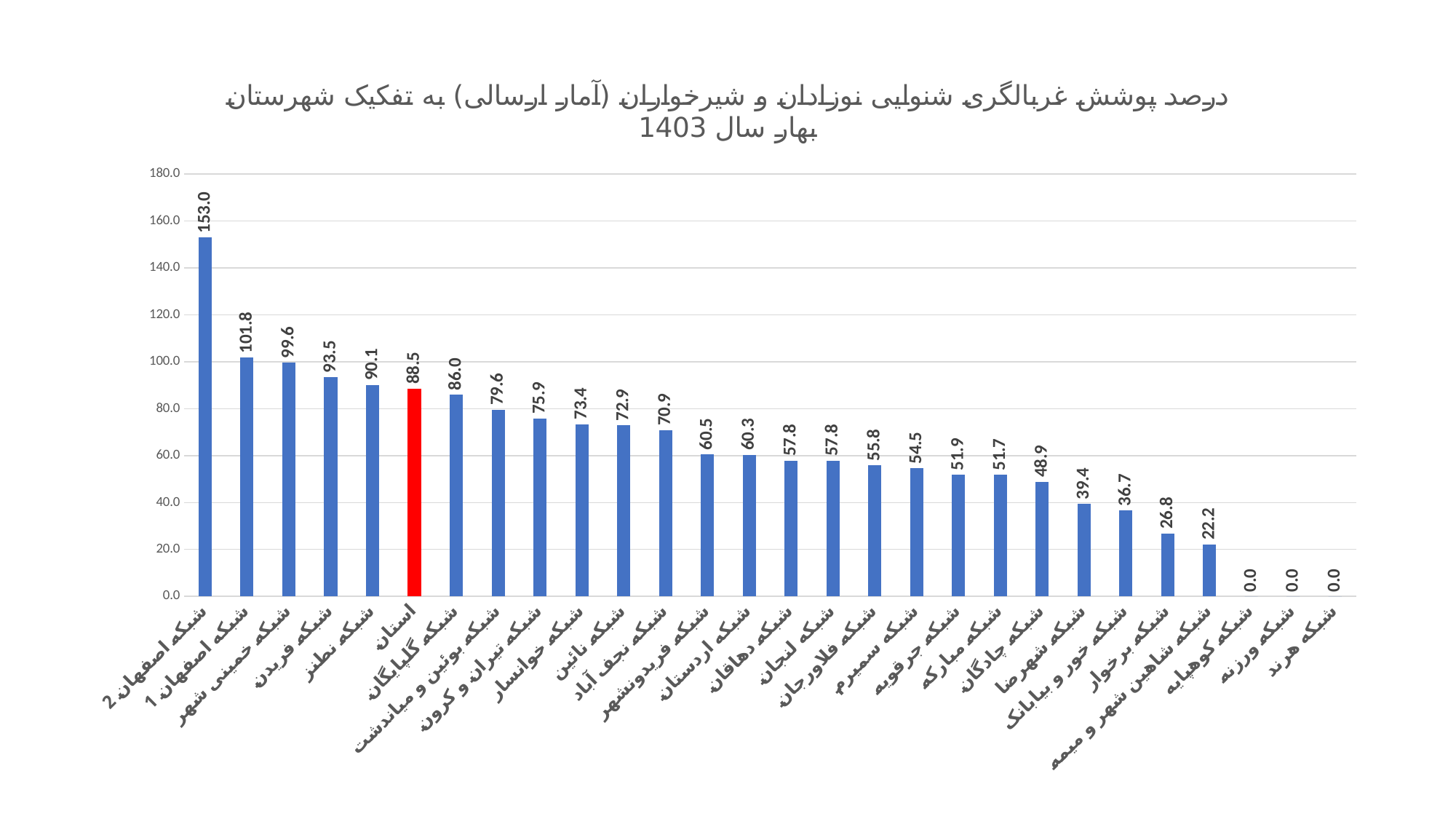
Which is larger, the value for شبکه گلپایگان or the value for شبکه نطنز? شبکه نطنز What is the value for شبکه نجف آباد? 70.9 Which category has the highest value? شبکه اصفهان 2 How many categories have a value of 0.0? 3 Do the values generally rise or fall from left to right along the x axis? fall What is the value for شبکه شاهین شهر و میمه? 22.2 Which bar is coloured red instead of blue? استان What is the value for استان (the red bar)? 88.5 What is the difference between the values for شبکه اصفهان 1 and شبکه خمینی شهر? 2.2 How many categories are shown on the x axis? 28 What is the value for شبکه اصفهان 2? 153.0 What type of chart is shown on the slide? bar chart